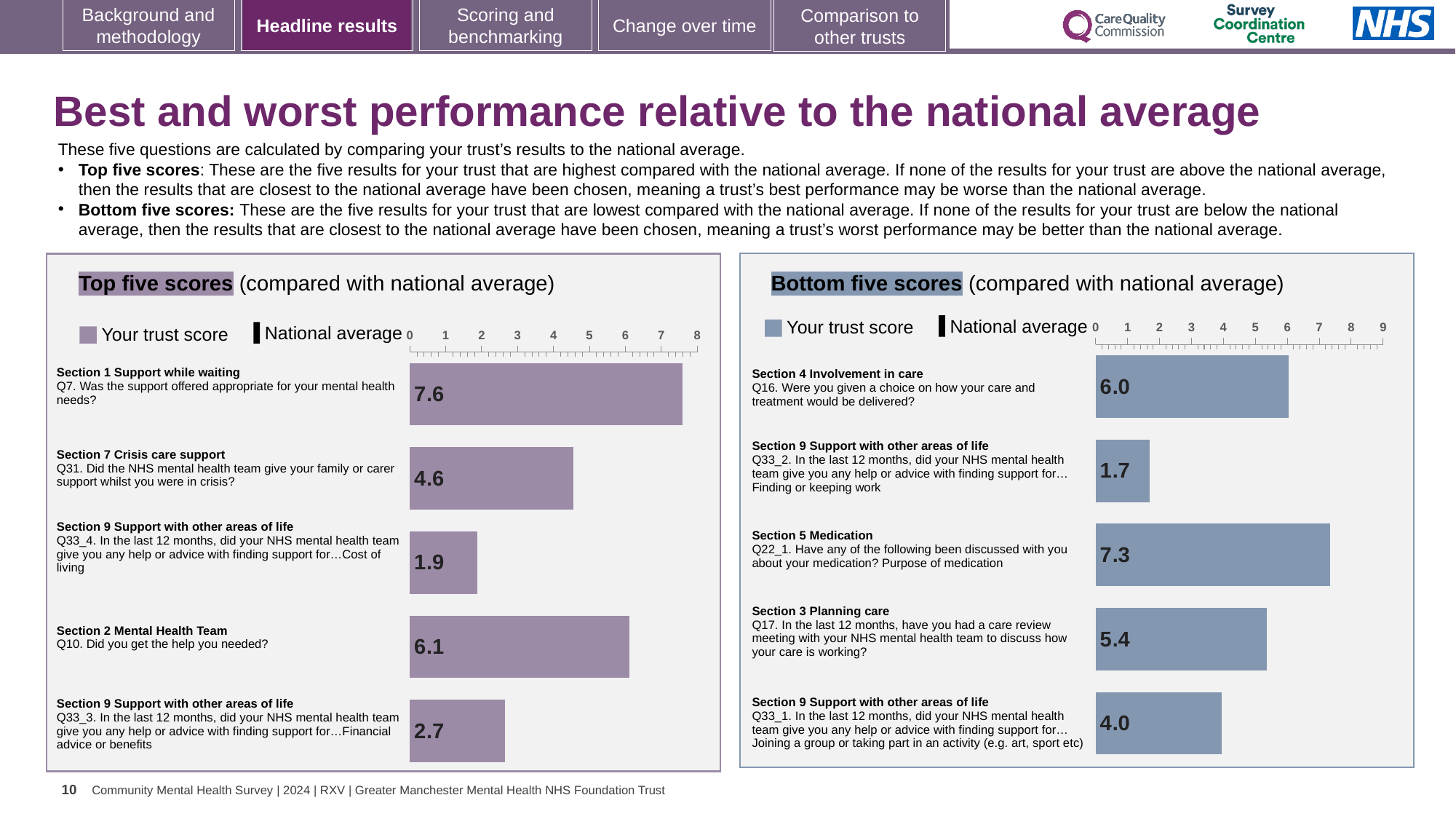
How many series does the legend of the Top five scores chart list? 2 In the Top five scores chart, which question has the lowest trust score? Q33_4 (Cost of living) In the Bottom five scores chart, what is the trust score for Q22_1 (Purpose of medication)? 7.3 In the Bottom five scores chart, is the trust score for Q17 greater or less than 5? greater What type of chart is used for the Top five scores? Bar chart In the Top five scores chart, what is the trust score for Q7 (Was the support offered appropriate for your mental health needs?)? 7.6 In the Bottom five scores chart, which question has the highest trust score? Q22_1 (Purpose of medication) In the Bottom five scores chart, what is the difference between the trust scores for Q16 and Q33_1? 2.0 In the Top five scores chart, what is the difference between the trust scores for Q7 and Q10? 1.5 How many bars are shown in the Bottom five scores chart? 5 In the Top five scores chart, which has the larger trust score: Q31 or Q33_3? Q31 In the Bottom five scores chart, which question has the lowest trust score? Q33_2 (Finding or keeping work)